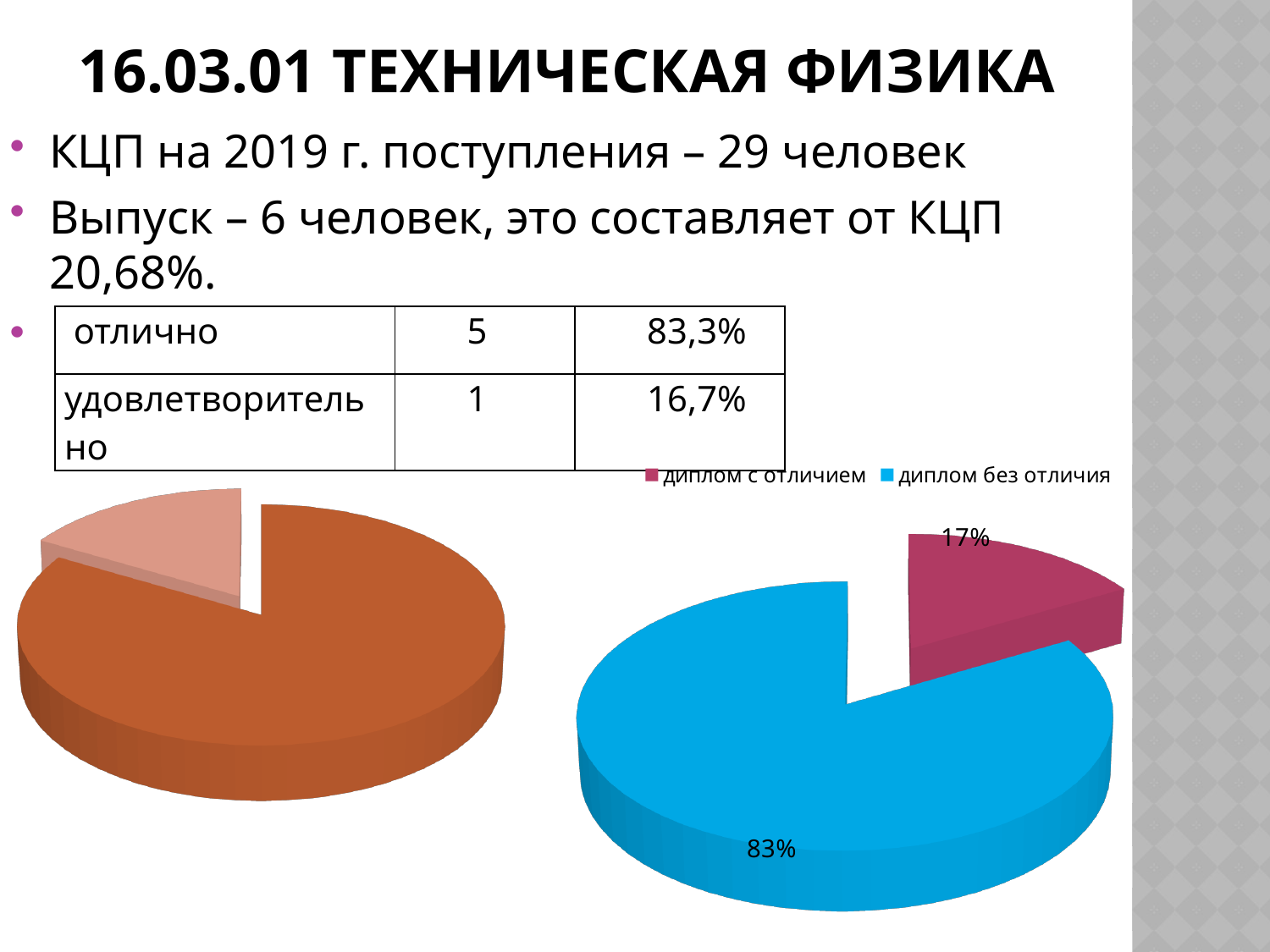
In the right pie chart, what percentage is shown for 'диплом с отличием'? 17% How many entries does the legend of the right pie chart list? 2 How many slices does the right pie chart have? 2 How many slices does the left pie chart have? 2 What kind of chart is the chart on the right side of the slide? pie chart In the right pie chart, which category has the smallest slice? диплом с отличием In the right pie chart, what percentage is shown for 'диплом без отличия'? 83% What kind of chart is the chart on the left side of the slide? pie chart In the right pie chart, what colour is the slice for 'диплом без отличия'? blue In the right pie chart, what is the difference in percentage points between 'диплом без отличия' and 'диплом с отличием'? 66 In the right pie chart, which is larger: 'диплом с отличием' or 'диплом без отличия'? диплом без отличия In the right pie chart, which category has the largest slice? диплом без отличия